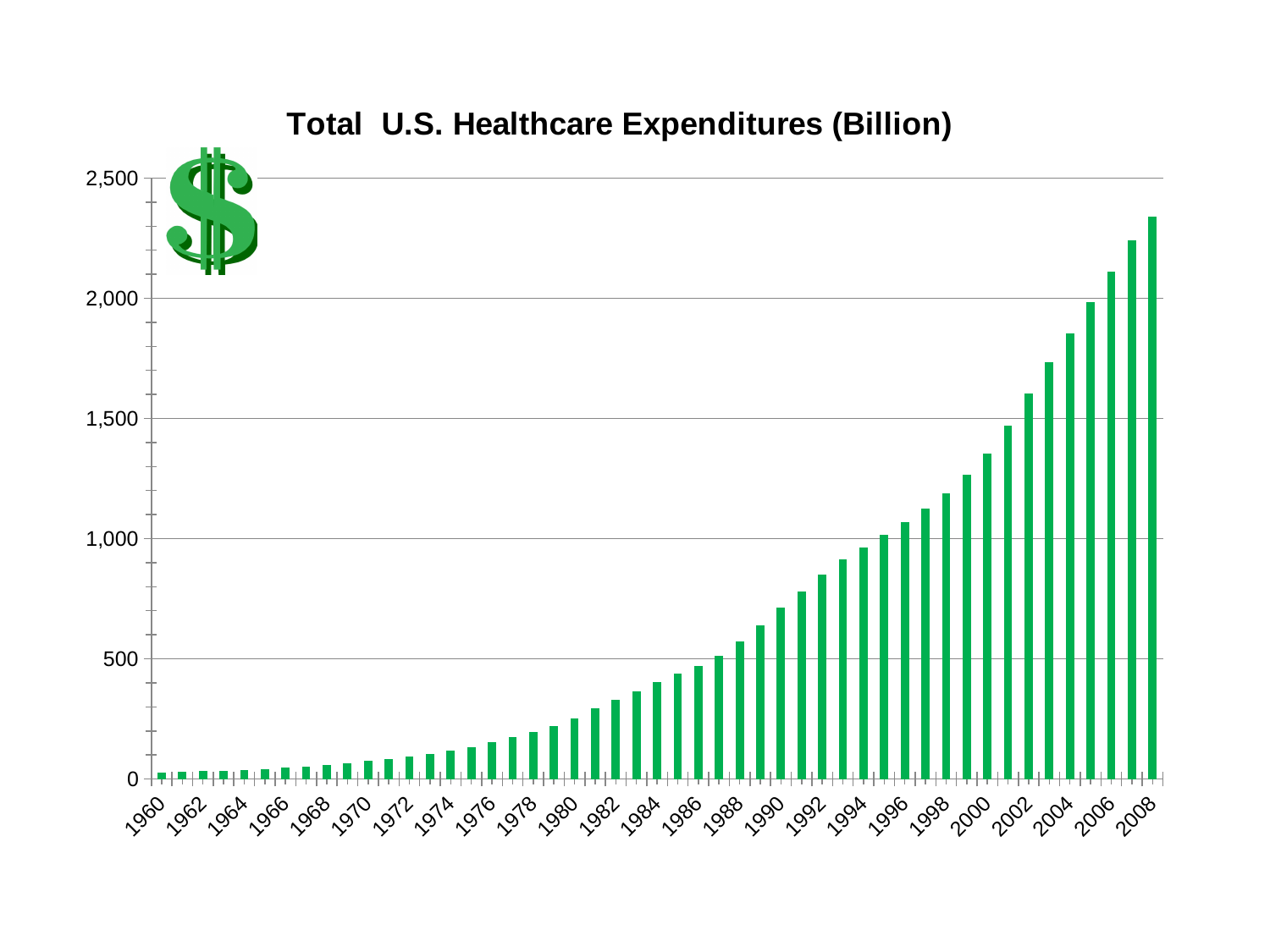
Do total U.S. healthcare expenditures rise or fall from 1960 to 2008? Rise Which year has the lowest total U.S. healthcare expenditure? 1960 Is the value for 1980 greater or less than 500? less How many bars (years) are plotted in the chart? 49 What is the title of the chart? Total U.S. Healthcare Expenditures (Billion) Is the value for 2008 greater or less than 2,000? greater Is the value for 1990 greater or less than 1,000? less What kind of chart is shown on the slide? Bar chart Which year has the larger total healthcare expenditure, 1990 or 2000? 2000 Which year has the highest total U.S. healthcare expenditure? 2008